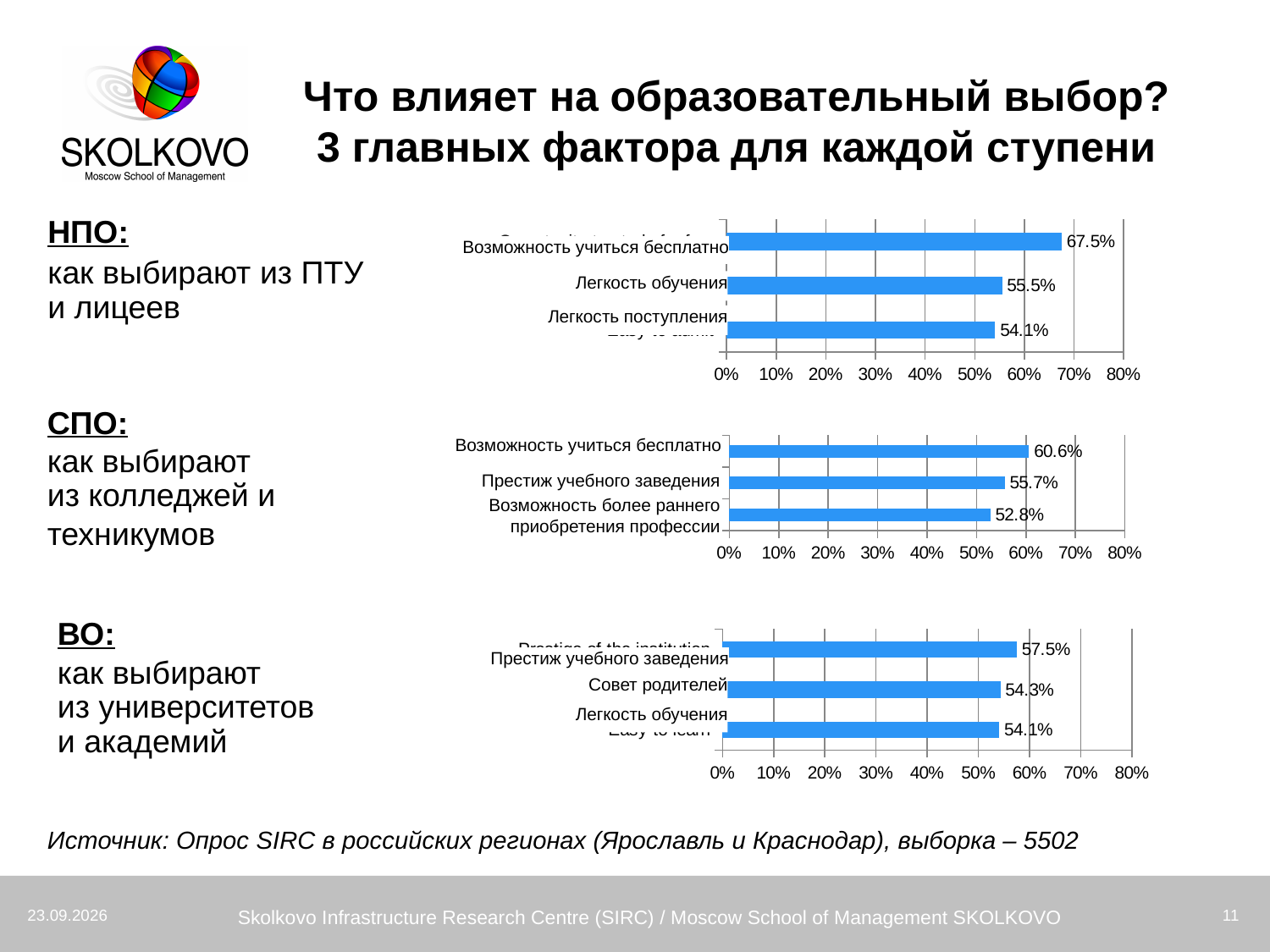
In the top chart (НПО), what is the value for Легкость поступления? 54.1% In the top chart (НПО), what is the difference between Возможность учиться бесплатно and Легкость обучения? 12 percentage points In the middle chart (СПО), which category has the lowest value? Возможность более раннего приобретения профессии In the top chart (НПО), which category has the highest value? Возможность учиться бесплатно What type of chart is used for the top chart (НПО)? Bar chart In the bottom chart (ВО), which is larger: Престиж учебного заведения or Легкость обучения? Престиж учебного заведения In the bottom chart (ВО), what is the value for Совет родителей? 54.3% In the bottom chart (ВО), what is the difference between Престиж учебного заведения and Легкость обучения? 3.4 percentage points In the middle chart (СПО), what is the value for Престиж учебного заведения? 55.7% In the top chart (НПО), what is the value for Возможность учиться бесплатно? 67.5% In the middle chart (СПО), is the value for Возможность учиться бесплатно greater or less than 60%? greater How many categories are shown in the middle chart (СПО)? 3